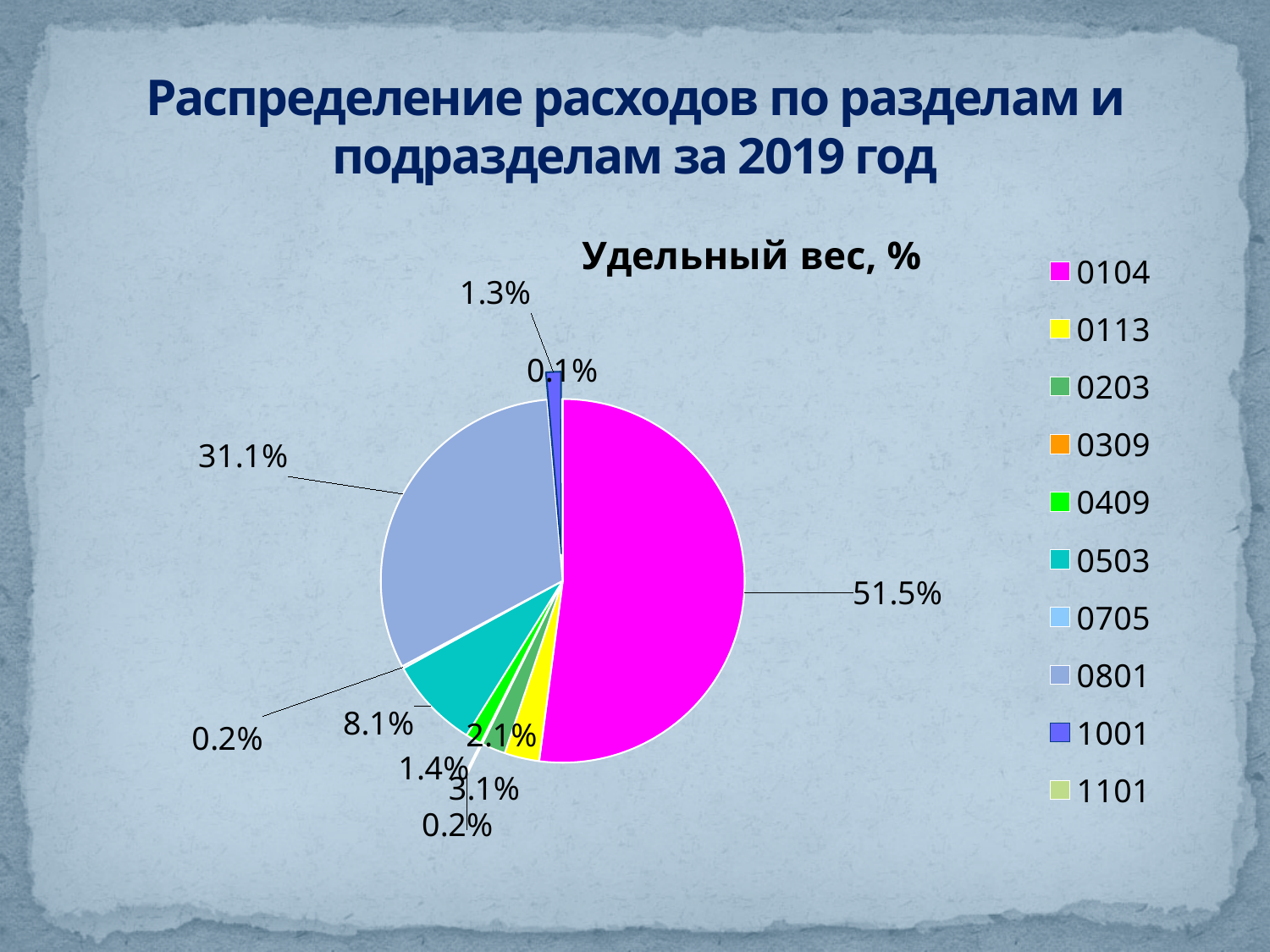
What is the value shown for category 0104 in the pie chart? 51.5% What share of the pie does category 0104 take? 51.5% What is the title of the chart? Удельный вес, % How many categories are listed in the chart legend? 10 Which category has the largest slice of the pie chart? 0104 What is the difference between the values for 0801 and 0503? 23.0 percentage points What kind of chart is shown on the slide? Pie chart What is the difference between the values for 0104 and 0801? 20.4 percentage points Which is larger, the slice for 0801 or the slice for 0503? 0801 What is the value shown for category 1001 in the pie chart? 1.3% What is the value shown for category 0503 in the pie chart? 8.1% What is the value shown for category 0801 in the pie chart? 31.1%